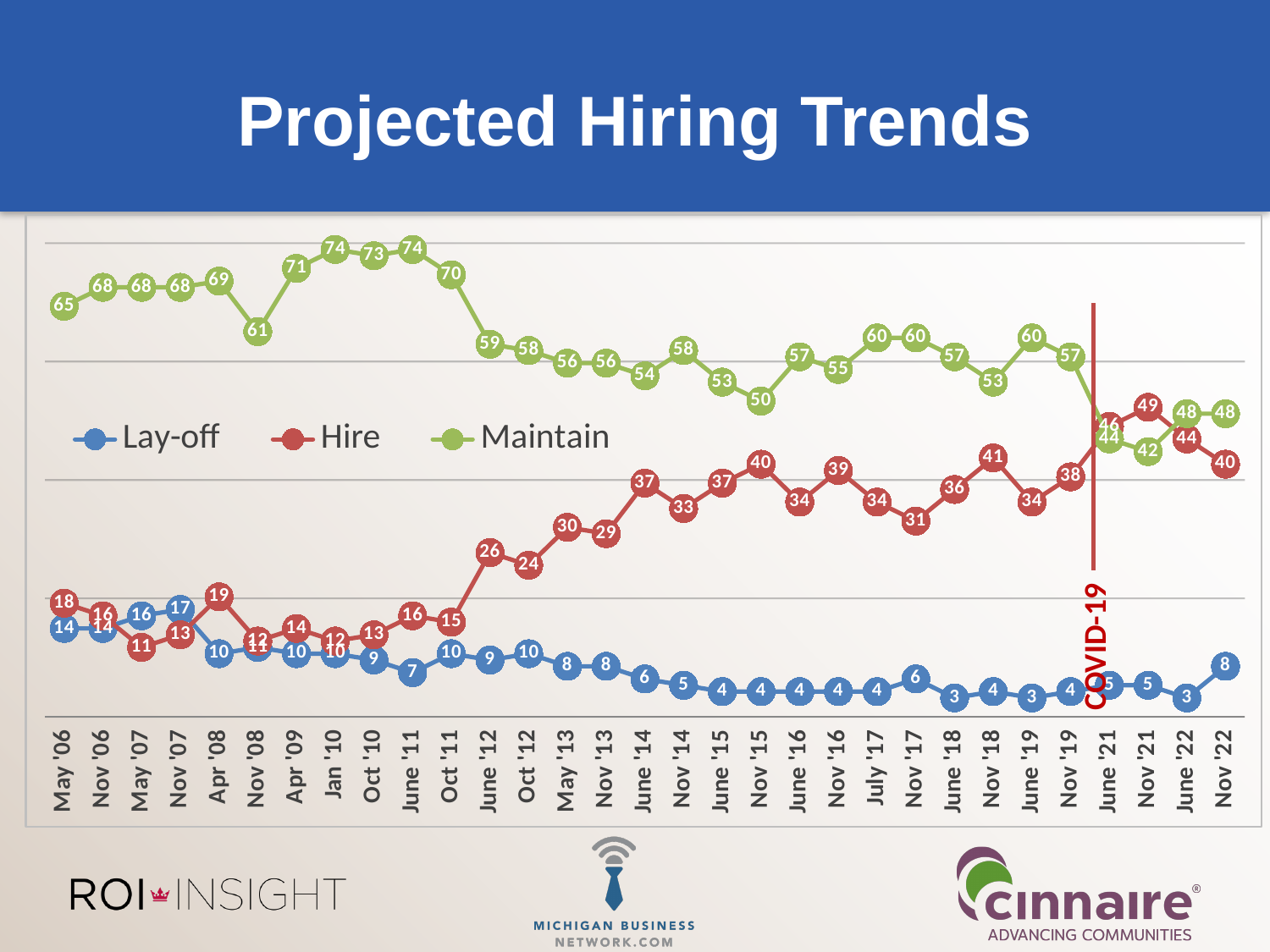
In which period is the Hire series at its highest? Nov '21 For May '06, which is larger: the Hire value or the Lay-off value? Hire What is the Lay-off value for Nov '22? 8 What is the Maintain value for Jan '10? 74 What is the Hire value for Nov '21? 49 What kind of chart is shown on the slide? Line chart In which period is the Maintain series at its lowest? Nov '21 What label is attached to the vertical red line on the chart? COVID-19 How many series does the legend list? 3 What is the Maintain value for Nov '15? 50 What is the difference between the Maintain value and the Hire value for Nov '19? 19 Does the Lay-off series generally rise or fall from May '06 to Nov '19? Fall